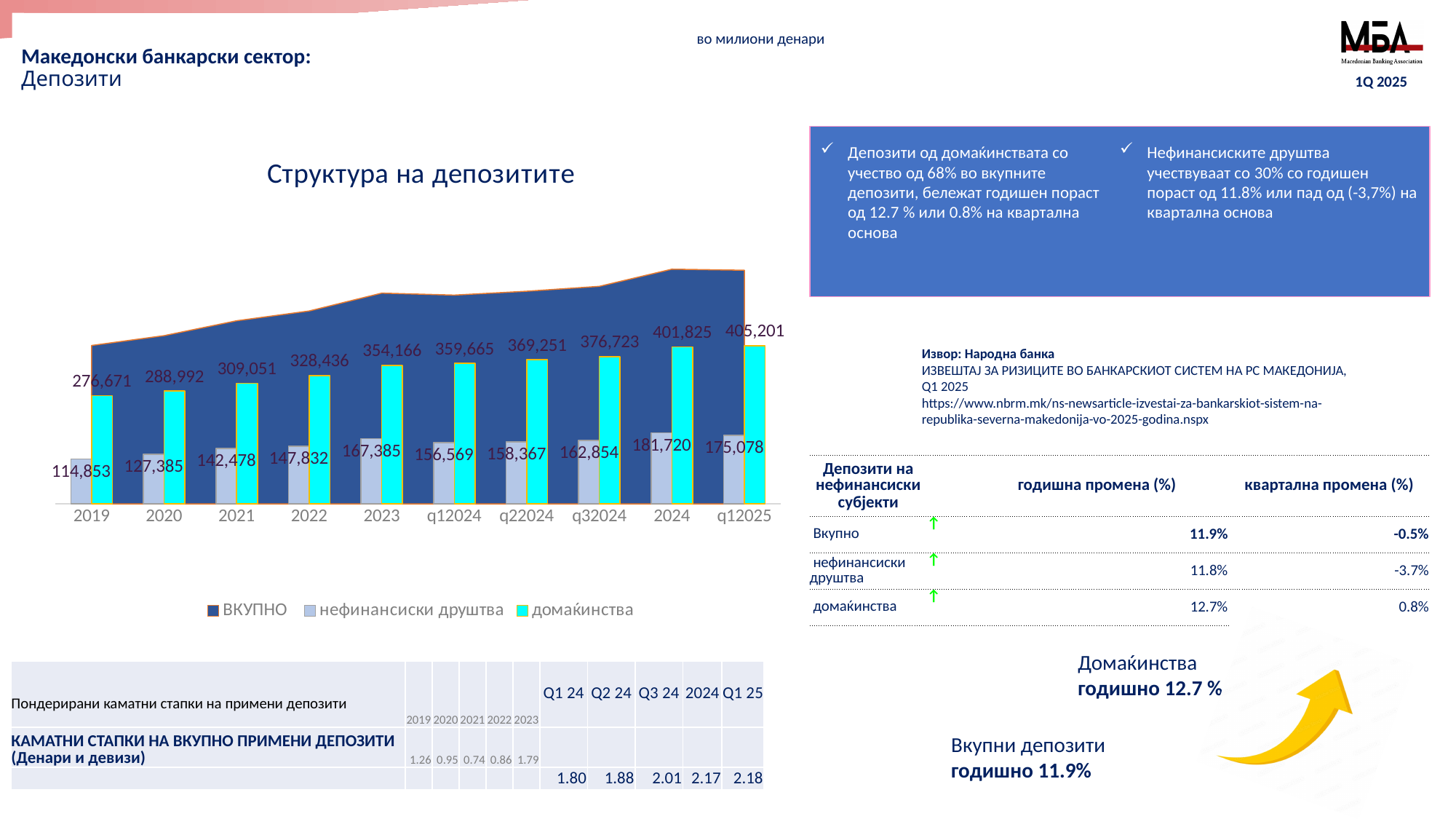
What is the value for домаќинства in q12025? 405,201 Do the домаќинства values rise or fall from 2019 to q12025? rise What is the title of the chart? Структура на депозитите How many series does the legend list? 3 How many periods are shown on the x axis? 10 What is the value for нефинансиски друштва in q12024? 156,569 What is the value for домаќинства in 2019? 276,671 Which is larger: нефинансиски друштва in 2023 or in q12024? 2023 In which period is the value for домаќинства lowest? 2019 What is the value for нефинансиски друштва in 2024? 181,720 In which period is the value for нефинансиски друштва highest? 2024 What is the difference between the домаќинства values for q12025 and 2024? 3,376